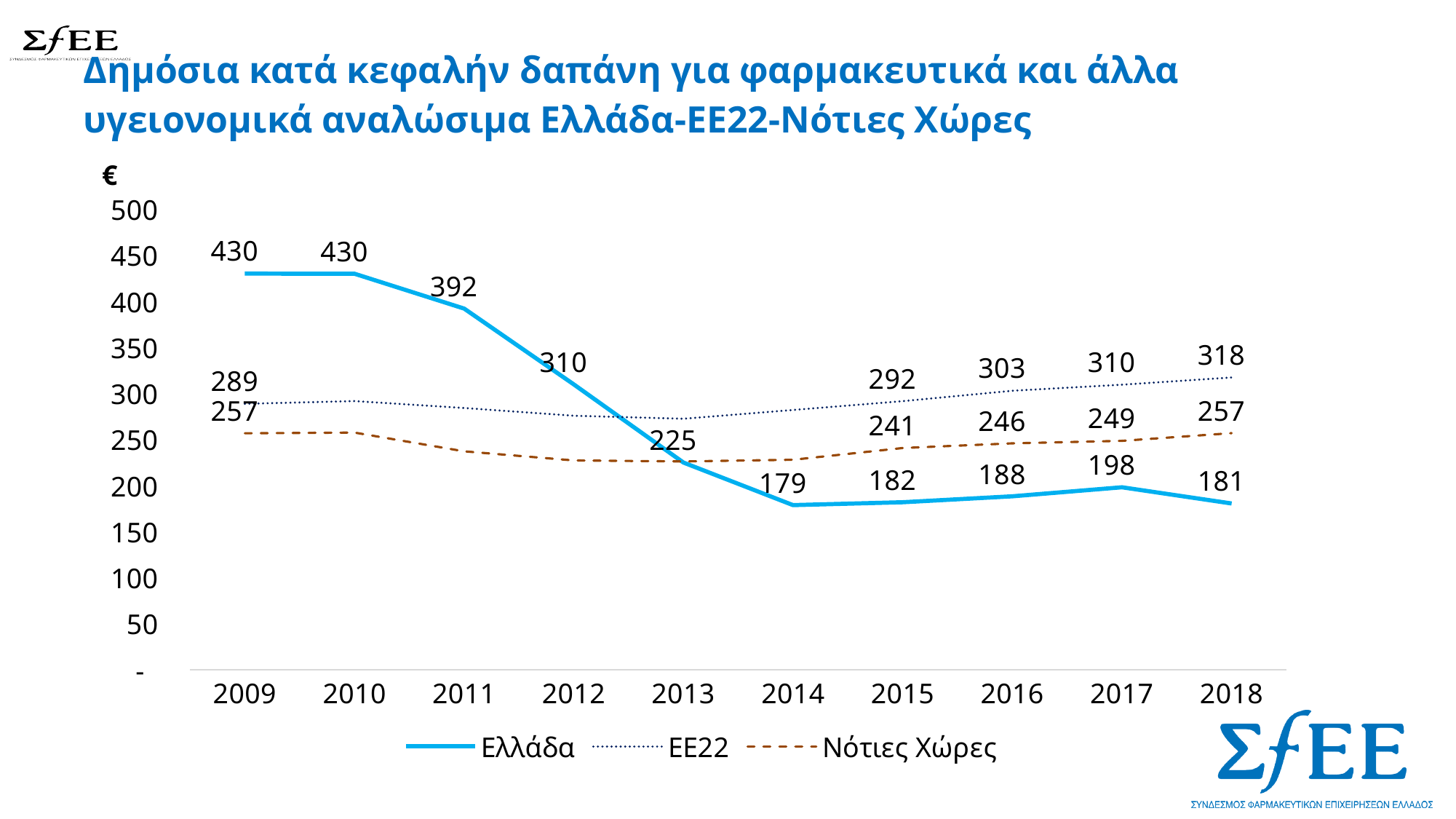
How many series does the legend list? 3 What is the value for Νότιες Χώρες in 2016? 246 How many years are shown on the x axis? 10 What kind of chart is shown on the slide? line chart Does the value for Ελλάδα rise or fall from 2009 to 2014? fall What is the value for Ελλάδα in 2009? 430 What is the difference between the Ελλάδα values in 2009 and 2018? 249 In which year is the value for Ελλάδα lowest? 2014 In 2018, which series has the larger value, ΕΕ22 or Νότιες Χώρες? ΕΕ22 What is the value for ΕΕ22 in 2018? 318 Is the value for ΕΕ22 in 2013 greater or less than 300? less What is the value for Ελλάδα in 2014? 179